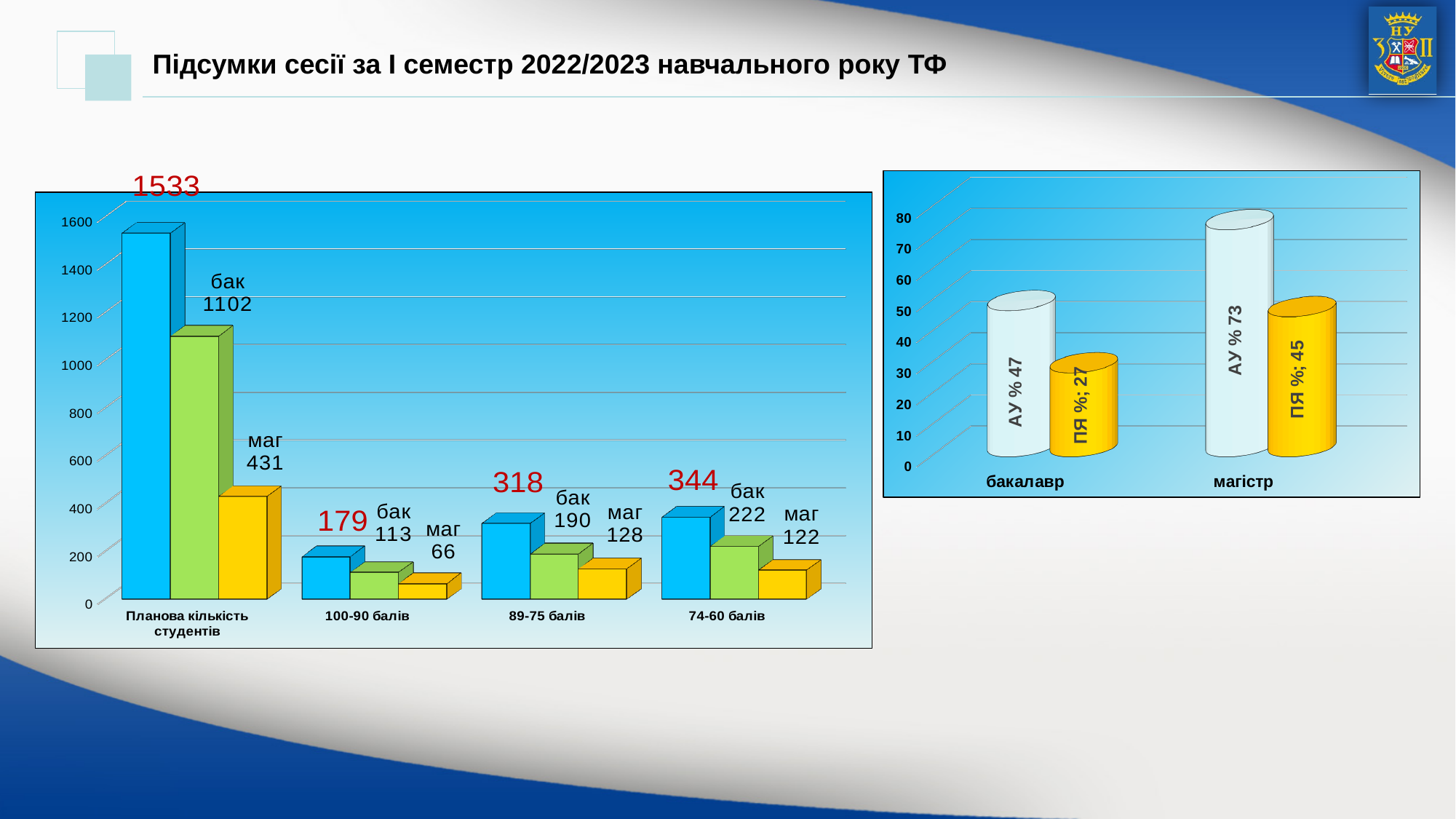
On the left chart, what is the total value shown for the category 'Планова кількість студентів'? 1533 On the left chart, what is the 'маг' value for the category '89-75 балів'? 128 On the left chart, what is the total value shown for the category '74-60 балів'? 344 On the right chart, what is the 'АУ %' value for 'магістр'? 73 On the left chart, which is larger: the total for '89-75 балів' or the total for '74-60 балів'? 74-60 балів On the left chart, how many categories are shown on the x axis? 4 What kind of chart is the left chart? bar chart On the left chart, what is the difference between the 'бак' value and the 'маг' value for 'Планова кількість студентів'? 671 On the left chart, what is the 'бак' value for the category '100-90 балів'? 113 On the right chart, what is the difference between the 'АУ %' values for 'магістр' and 'бакалавр'? 26 On the left chart, which category has the lowest total value? 100-90 балів On the right chart, what is the 'ПЯ %' value for 'бакалавр'? 27